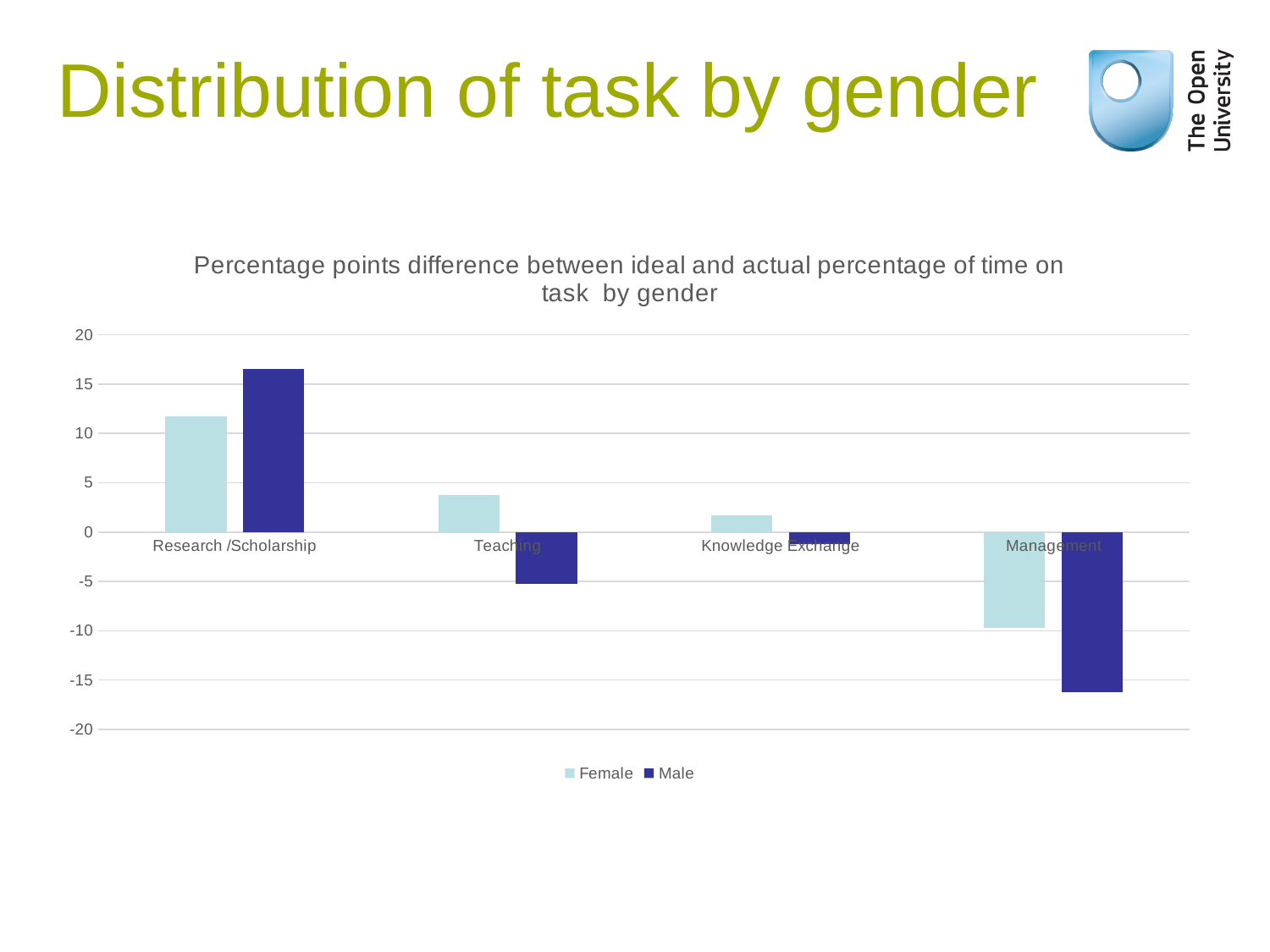
Is the Male value for Research /Scholarship greater or less than 15? greater Which category has the lowest Male value? Management How many series does the legend list? 2 Which category has the highest Male value? Research /Scholarship Which is larger for Research /Scholarship, the Female value or the Male value? Male Is the Male value for Management greater or less than -15? less How many task categories are shown on the x axis? 4 Is the Female value for Research /Scholarship greater or less than 10? greater What are the two series named in the legend? Female and Male Which is larger for Teaching, the Female value or the Male value? Female Which category has the lowest Female value? Management What kind of chart is shown on the slide? bar chart